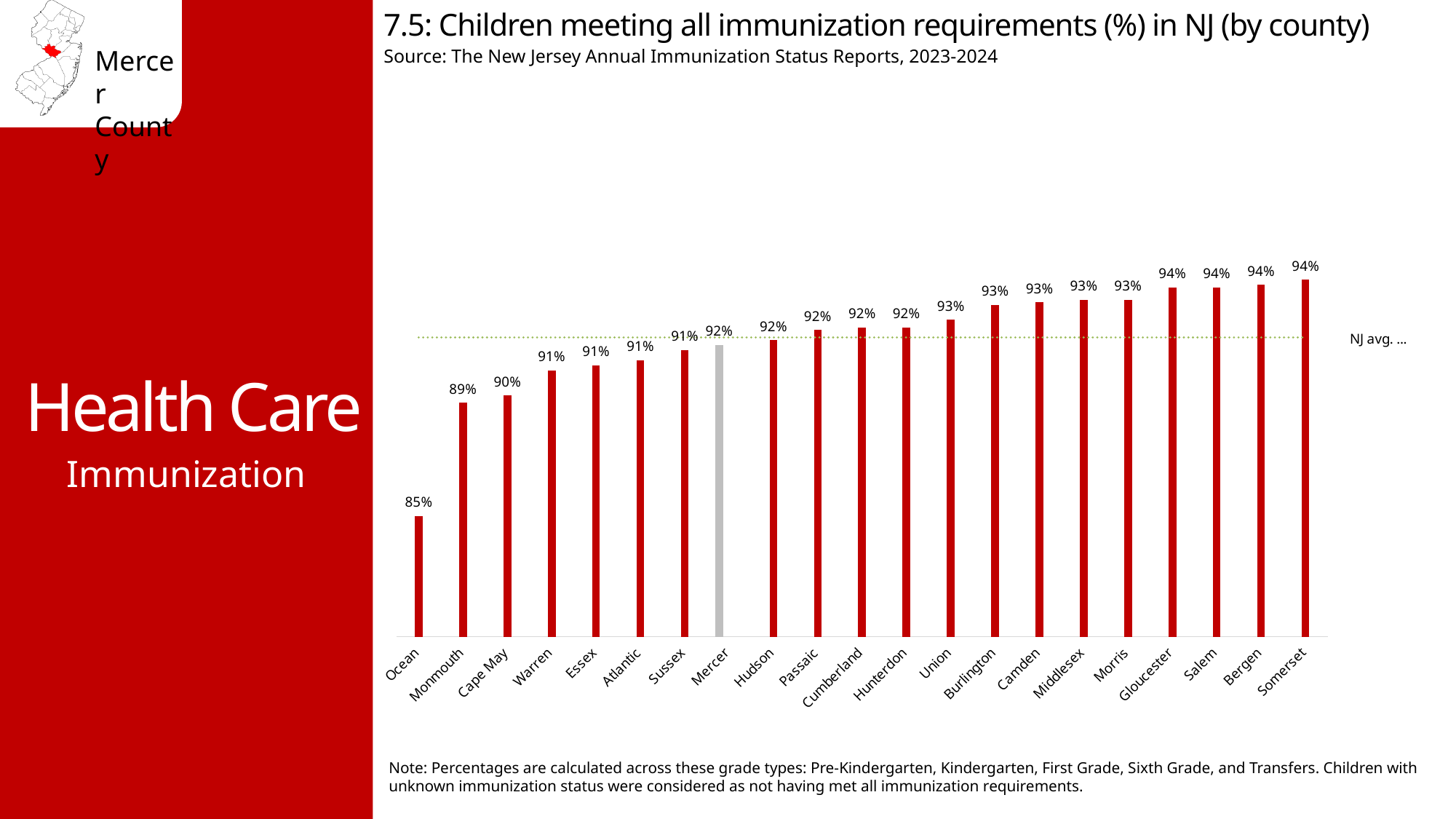
Which county has the lowest percentage of children meeting all immunization requirements? Ocean What percentage is shown for Cape May? 90% Which has a higher value, Cape May or Union? Union Do the values generally rise or fall moving from left to right across the counties? Rise What is the value shown for Somerset County? 94% What is the difference in percentage points between Somerset and Ocean? 9 percentage points How many percentage points higher is Mercer than Ocean? 7 percentage points What percentage of children in Ocean County met all immunization requirements? 85% Which has a higher value, Monmouth or Ocean? Monmouth What kind of chart is shown on the slide? Bar chart What is the value shown for Mercer County? 92% How many counties are shown on the chart? 21